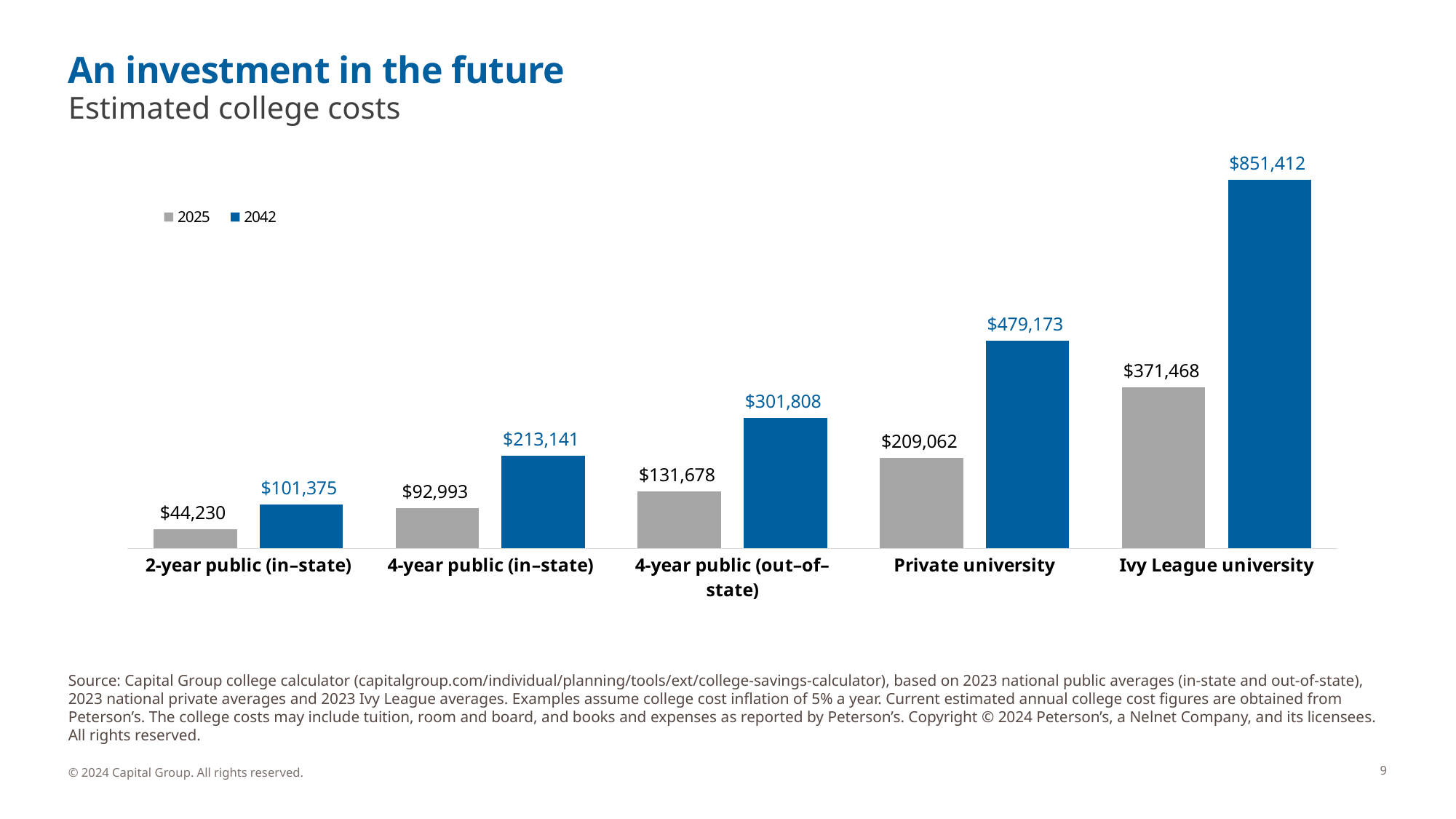
What is the difference between the 2042 and 2025 estimated costs for a 4-year public (out-of-state) college? $170,130 What is the estimated 2025 cost for a Private university? $209,062 What is the estimated 2025 cost for a 2-year public (in-state) college? $44,230 What is the difference between the 2042 and 2025 estimated costs for an Ivy League university? $479,944 Which is larger: the 2025 cost for an Ivy League university or the 2042 cost for a 4-year public (out-of-state) college? 2025 cost for an Ivy League university How many series does the legend list? 2 Which category has the highest estimated 2042 cost? Ivy League university Which category has the lowest estimated 2025 cost? 2-year public (in-state) How many college categories are shown on the x axis? 5 Which year does the blue series in the legend represent? 2042 What kind of chart is shown on the slide? Bar chart What is the estimated 2042 cost for a 4-year public (in-state) college? $213,141